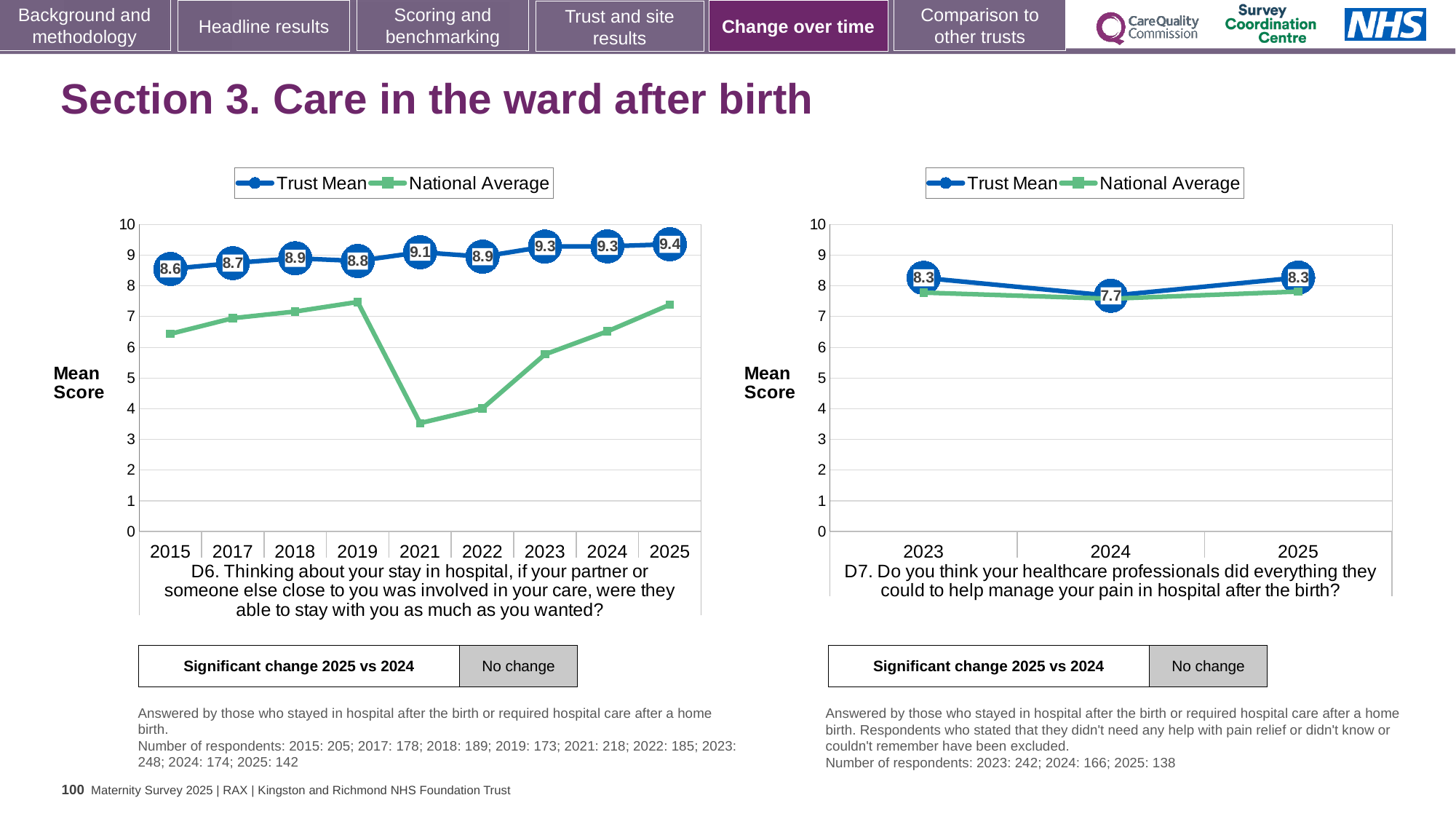
In the D6 chart on the left, is the National Average for 2021 greater or less than 4? less In the D6 chart on the left, which year has the highest Trust Mean score? 2025 In the D6 chart on the left, what is the difference between the Trust Mean scores for 2025 and 2015? 0.8 In the D7 chart on the right, what is the Trust Mean score for 2024? 7.7 How many series does the legend of the D6 chart on the left list? 2 In the D6 chart on the left, what is the Trust Mean score for 2015? 8.6 In the D6 chart on the left, what is the Trust Mean score for 2025? 9.4 In the D6 chart on the left, which is larger in 2021: the Trust Mean or the National Average? Trust Mean In the D7 chart on the right, what is the difference between the Trust Mean scores for 2023 and 2024? 0.6 How many years are plotted on the x axis of the D7 chart on the right? 3 In the D6 chart on the left, which year has the lowest Trust Mean score? 2015 In the D7 chart on the right, which year has the lowest Trust Mean score? 2024